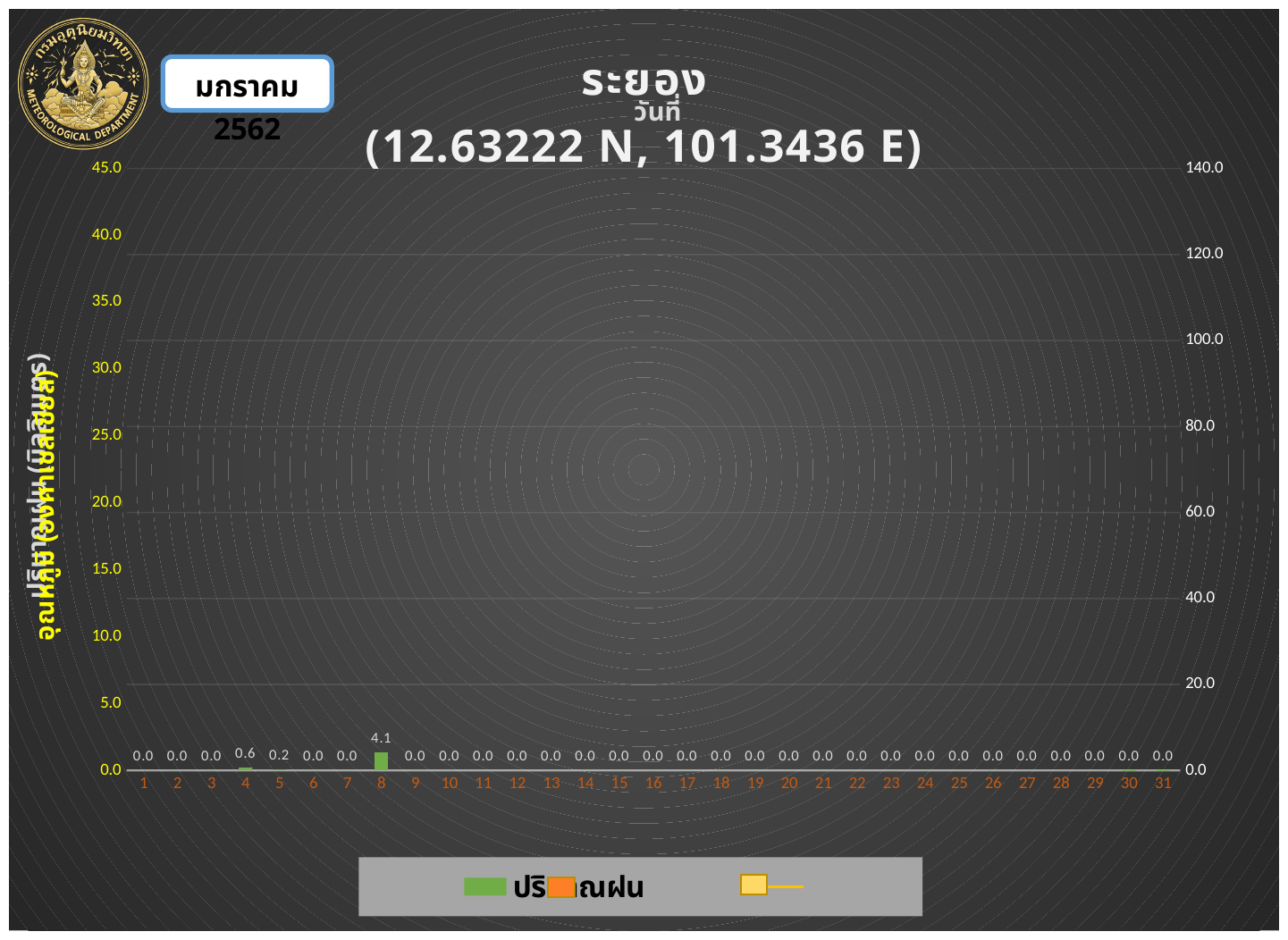
What kind of chart is shown on the slide? bar chart What is the value labelled for day 5? 0.2 What is the difference between the values for day 8 and day 4? 3.5 Is the value for day 8 greater or less than 5.0? less What is the highest tick value shown on the left vertical axis? 45.0 What is the value labelled for day 4? 0.6 What is the rainfall value labelled for day 8? 4.1 What is the value labelled for day 1? 0.0 Which has the larger value, day 4 or day 5? day 4 Which day has the highest bar in the chart? 8 What is the highest tick value shown on the right vertical axis? 140.0 How many days are shown along the x axis of the chart? 31